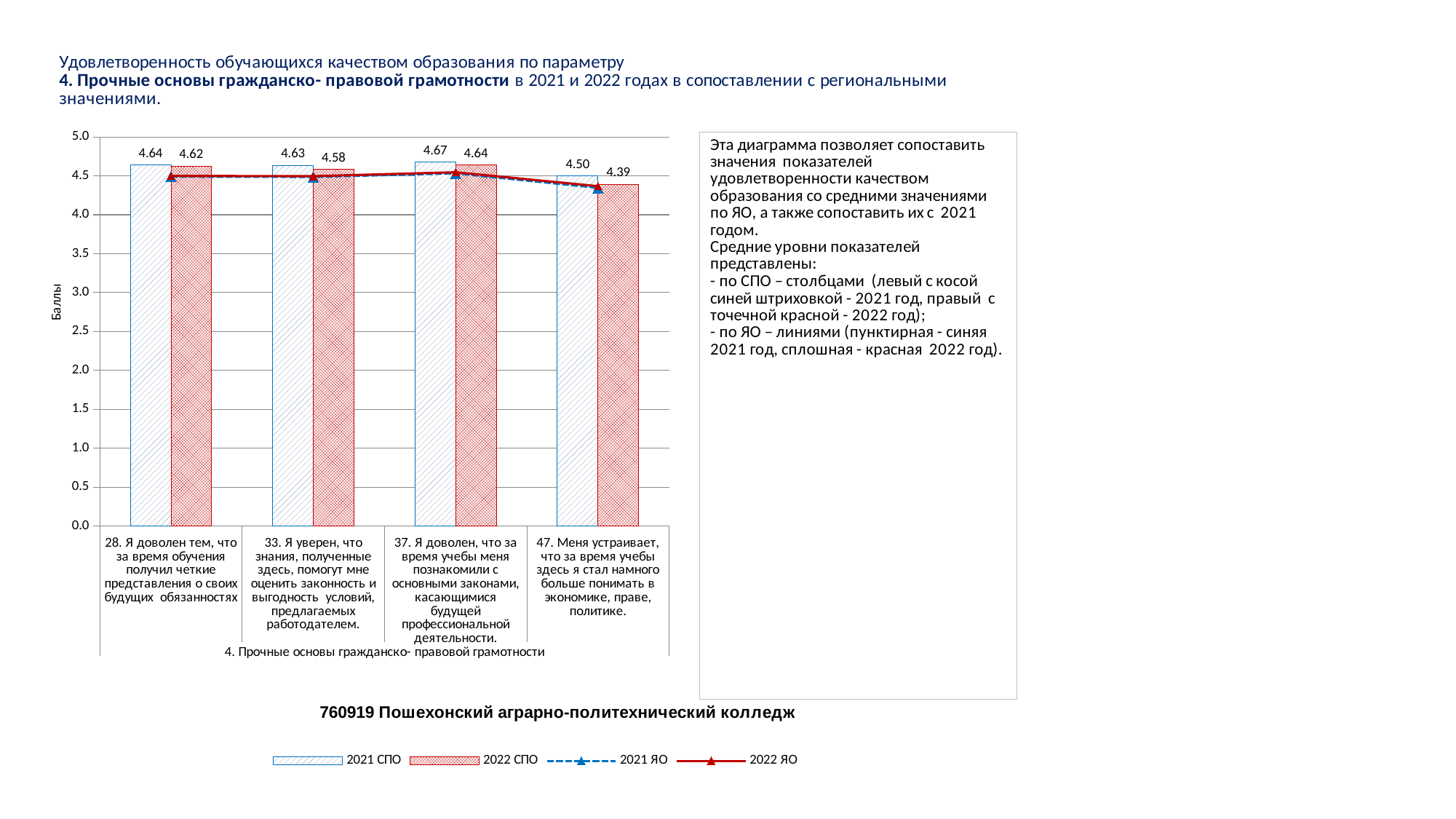
Which item has the lowest 2022 СПО value? 47. Меня устраивает, что за время учебы здесь я стал намного больше понимать в экономике, праве, политике. What is the 2022 СПО value for item 47 ("Меня устраивает, что за время учебы здесь я стал намного больше понимать в экономике, праве, политике")? 4.39 Which item has the highest 2021 СПО value? 37. Я доволен, что за время учебы меня познакомили с основными законами, касающимися будущей профессиональной деятельности. What kind of chart is shown on the slide? Combined bar and line chart Is the 2022 ЯО line value for item 47 greater or less than 4.0? greater What is the 2022 СПО value for item 33 ("Я уверен, что знания, полученные здесь, помогут мне оценить законность и выгодность условий, предлагаемых работодателем")? 4.58 What is the label of the vertical axis of the chart? Баллы How many series does the chart legend list? 4 How many items (categories) are shown on the x axis of the chart? 4 What is the 2021 СПО value for item 28 ("Я доволен тем, что за время обучения получил четкие представления о своих будущих обязанностях")? 4.64 For item 37, which is larger: the 2021 СПО value or the 2022 СПО value? 2021 СПО What is the difference between the 2021 СПО and 2022 СПО values for item 47? 0.11